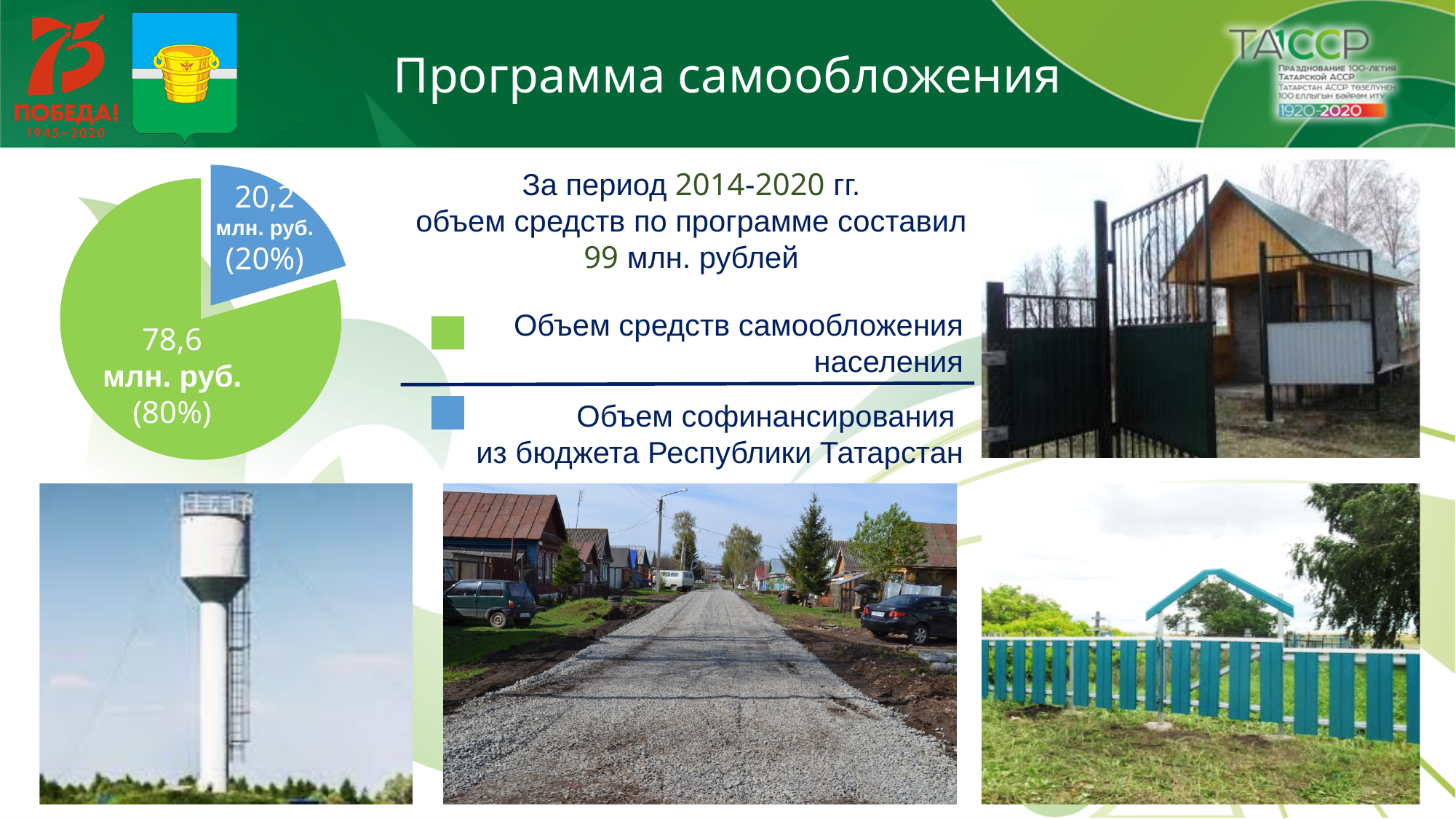
What is the difference in млн. руб. between the two slices of the pie chart? 58,4 млн. руб. What colour is the slice for "Объем софинансирования из бюджета Республики Татарстан"? blue Which slice of the pie chart is the largest? Объем средств самообложения населения What value is shown for the slice "Объем софинансирования из бюджета Республики Татарстан"? 20,2 млн. руб. What colour is the slice for "Объем средств самообложения населения"? green What share of the pie does "Объем средств самообложения населения" take? 80% Which slice of the pie chart is the smallest? Объем софинансирования из бюджета Республики Татарстан How many slices does the pie chart have? 2 What share of the pie does "Объем софинансирования из бюджета Республики Татарстан" take? 20% Which is larger: the value for "Объем средств самообложения населения" or for "Объем софинансирования из бюджета Республики Татарстан"? Объем средств самообложения населения What value is shown for the slice "Объем средств самообложения населения"? 78,6 млн. руб. What kind of chart is shown on the slide? pie chart